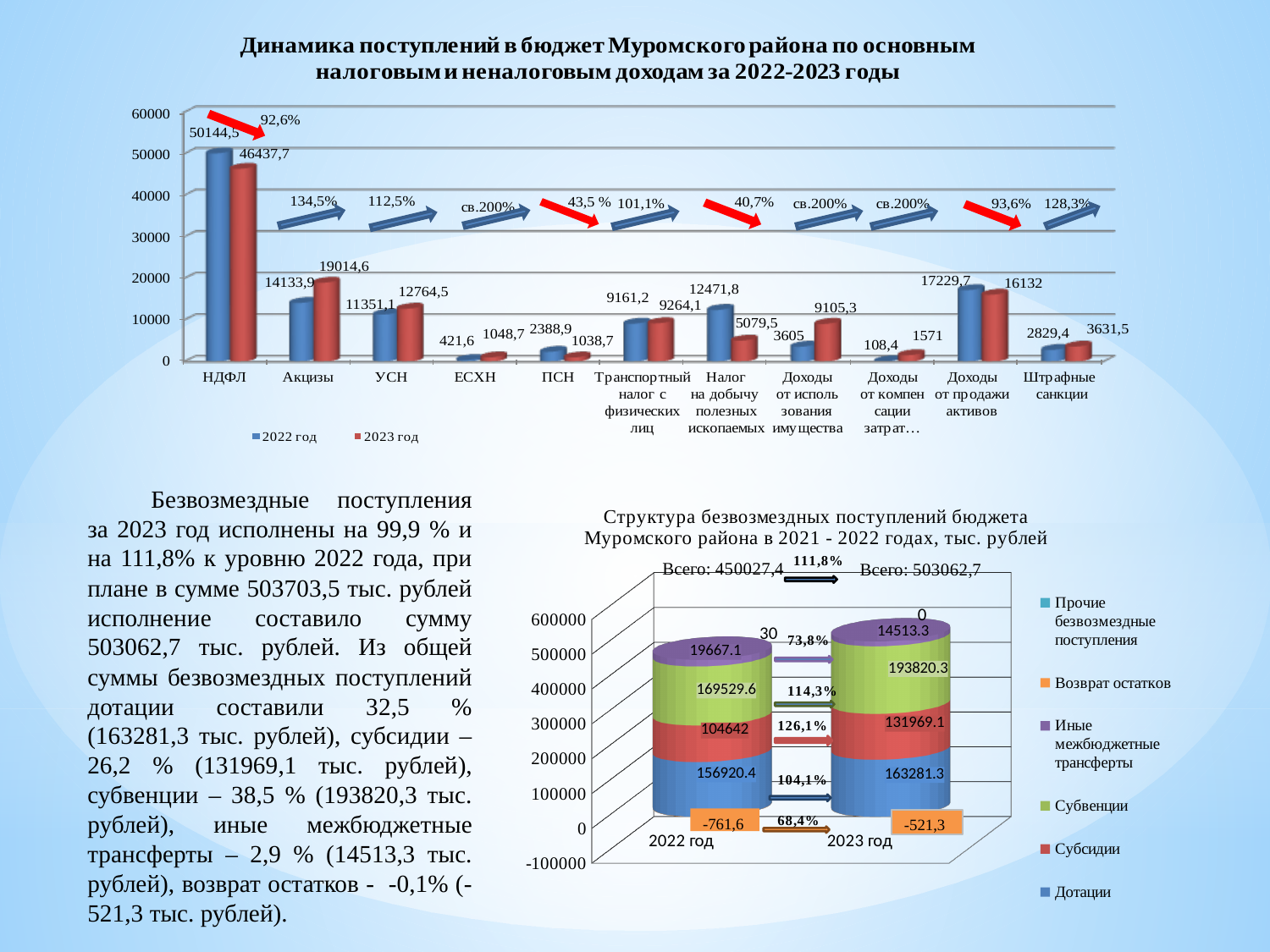
In the bottom chart, what is the total shown for 2022 год? 450027,4 In the top chart, what is the value for Налог на добычу полезных ископаемых in 2023 год? 5079,5 In the top chart, which category has the lowest value in 2022 год? Доходы от компенсации затрат How many series does the legend of the bottom chart list? 6 In the top chart, what is the value for Акцизы in 2023 год? 19014,6 In the bottom chart (Структура безвозмездных поступлений), what is the value of Субвенции for 2023 год? 193820.3 In the top chart, which is larger for ПСН: the 2022 год value or the 2023 год value? 2022 год In the top chart, which category has the highest value in 2022 год? НДФЛ In the top chart, what is the difference between the 2022 год and 2023 год values for НДФЛ? 3706,8 How many categories are shown on the x axis of the top chart? 11 In the top chart (Динамика поступлений в бюджет Муромского района), what is the value for НДФЛ in 2022 год? 50144,5 How many series does the legend of the top chart list? 2